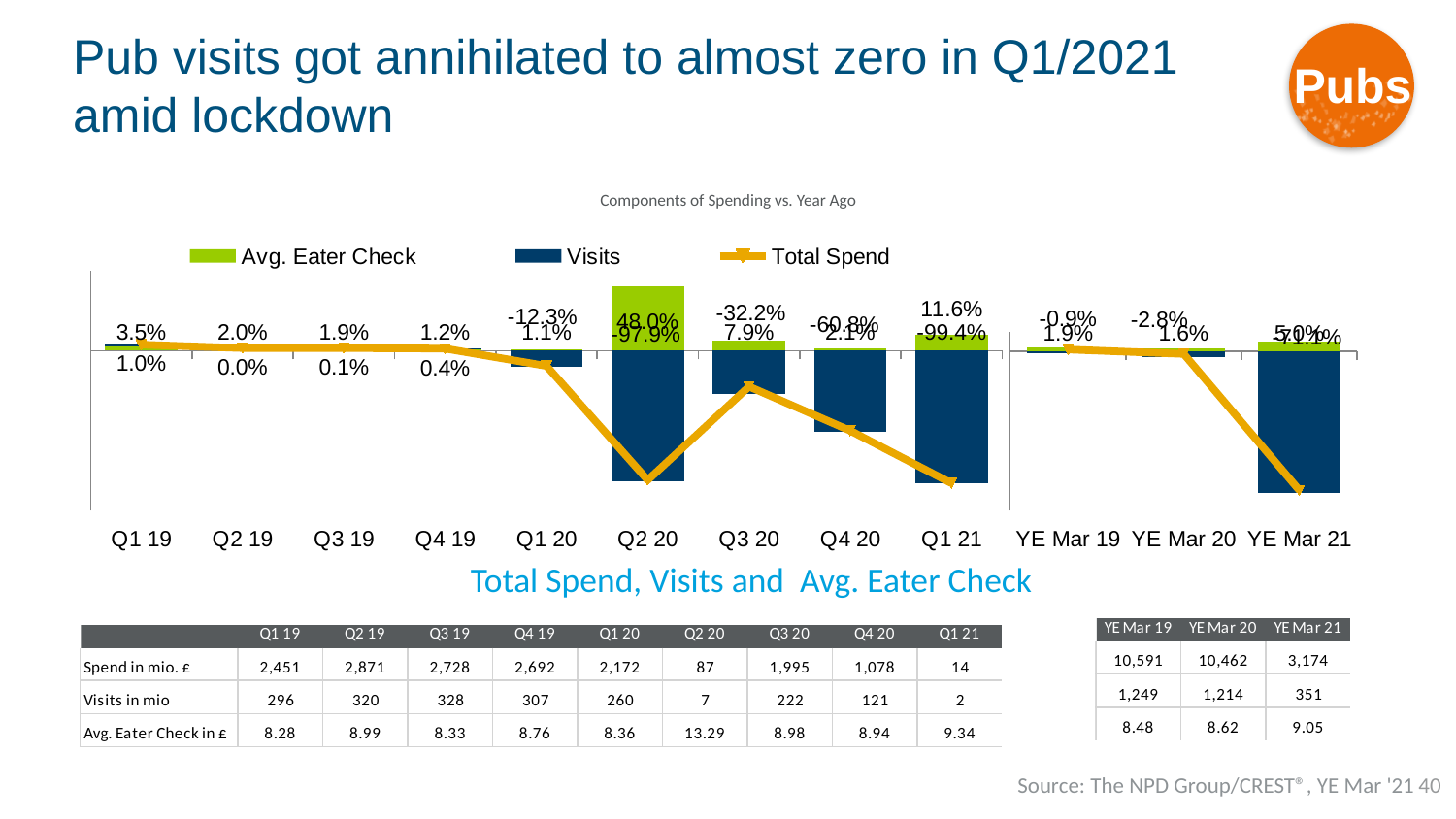
How many series does the chart legend list? 3 How many categories are shown along the x axis of the chart? 12 Which is larger, the Visits value for Q3 20 or for Q4 20? Q3 20 Which category has the highest Avg. Eater Check value? Q2 20 What is the Visits value for Q1 20? -12.3% What kind of chart is shown on the slide? bar and line chart Which series is drawn as a line in the chart? Total Spend Which category has the lowest Visits value? Q1 21 What is the Visits value for Q1 21? -99.4% What is the Visits value for YE Mar 21? -71.1% What is the Avg. Eater Check value for Q2 20? 48.0% What is the Visits value for Q2 20? -97.9%